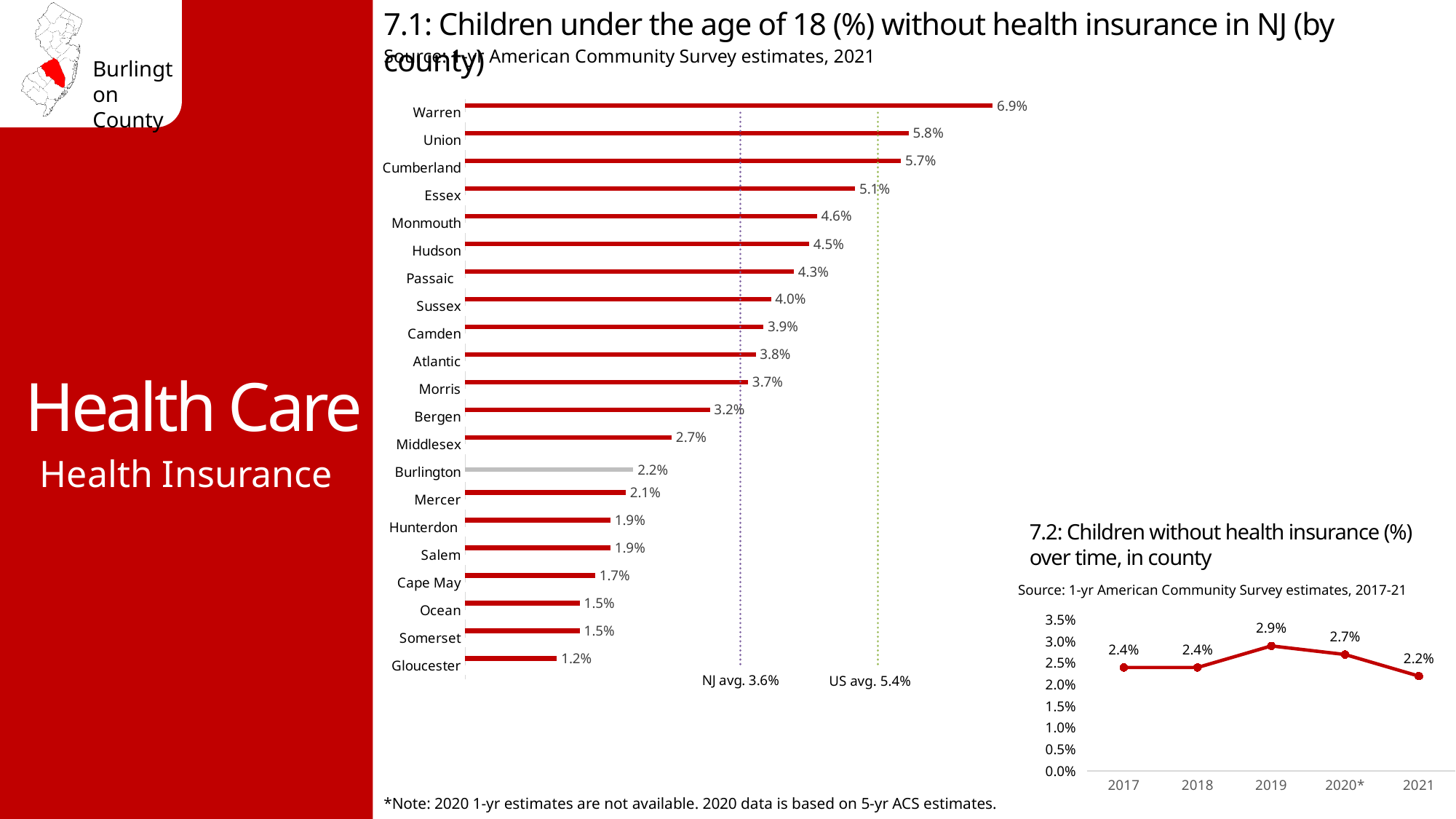
What kind of chart is chart 7.1 (children without health insurance by county)? Bar chart In chart 7.1 (children without health insurance by county), how many counties are shown? 21 In chart 7.1 (children without health insurance by county), what is the US average shown by the dotted line? 5.4% In chart 7.1 (children without health insurance by county), what is the NJ average shown by the dotted line? 3.6% What kind of chart is chart 7.2 (children without health insurance over time)? Line chart In chart 7.1 (children without health insurance by county), what is the difference between Warren and Gloucester? 5.7% In chart 7.2 (children without health insurance over time), what is the value for 2019? 2.9% In chart 7.2 (children without health insurance over time), what is the difference between 2019 and 2021? 0.7% In chart 7.1 (children without health insurance by county), which is larger, the value for Hudson or the value for Camden? Hudson In chart 7.1 (children without health insurance by county), which county has the highest value? Warren In chart 7.1 (children without health insurance by county), which county has the lowest value? Gloucester In chart 7.1 (children without health insurance by county), what is the value for Burlington? 2.2%